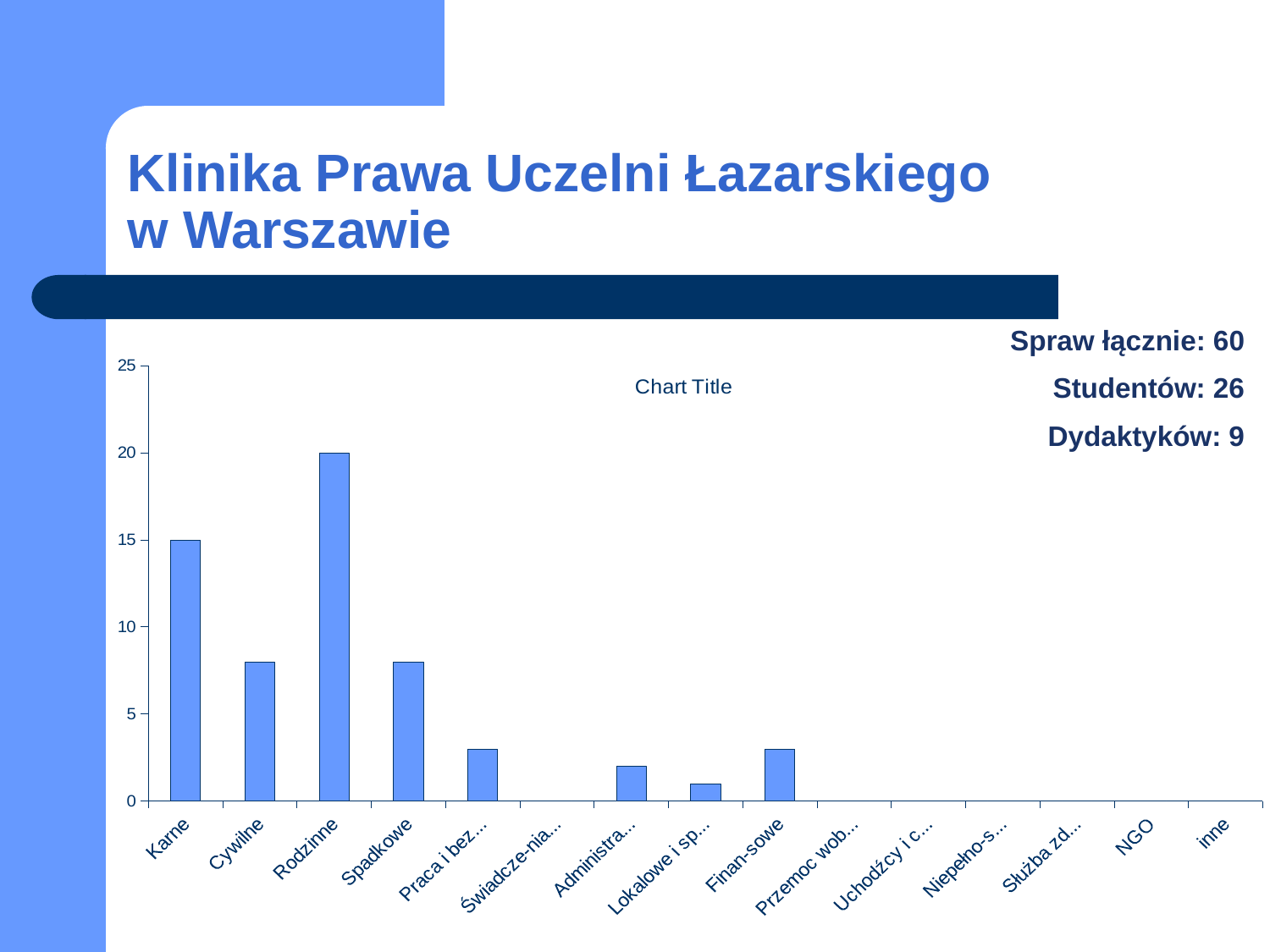
Which is larger, the value for Karne or the value for Cywilne? Karne Is the value for Cywilne greater or less than 10? less What is the value for Rodzinne? 20 What is the difference between the values for Rodzinne and Karne? 5 What is the value for Karne? 15 What kind of chart is shown on the slide? bar chart Which is larger, the value for Spadkowe or the value for Administra...? Spadkowe What is the title shown on the chart? Chart Title How many categories are shown on the x axis of the chart? 15 Which category has the highest bar in the chart? Rodzinne Is the value for Spadkowe greater or less than 5? greater Is the value for Finan-sowe greater or less than 5? less